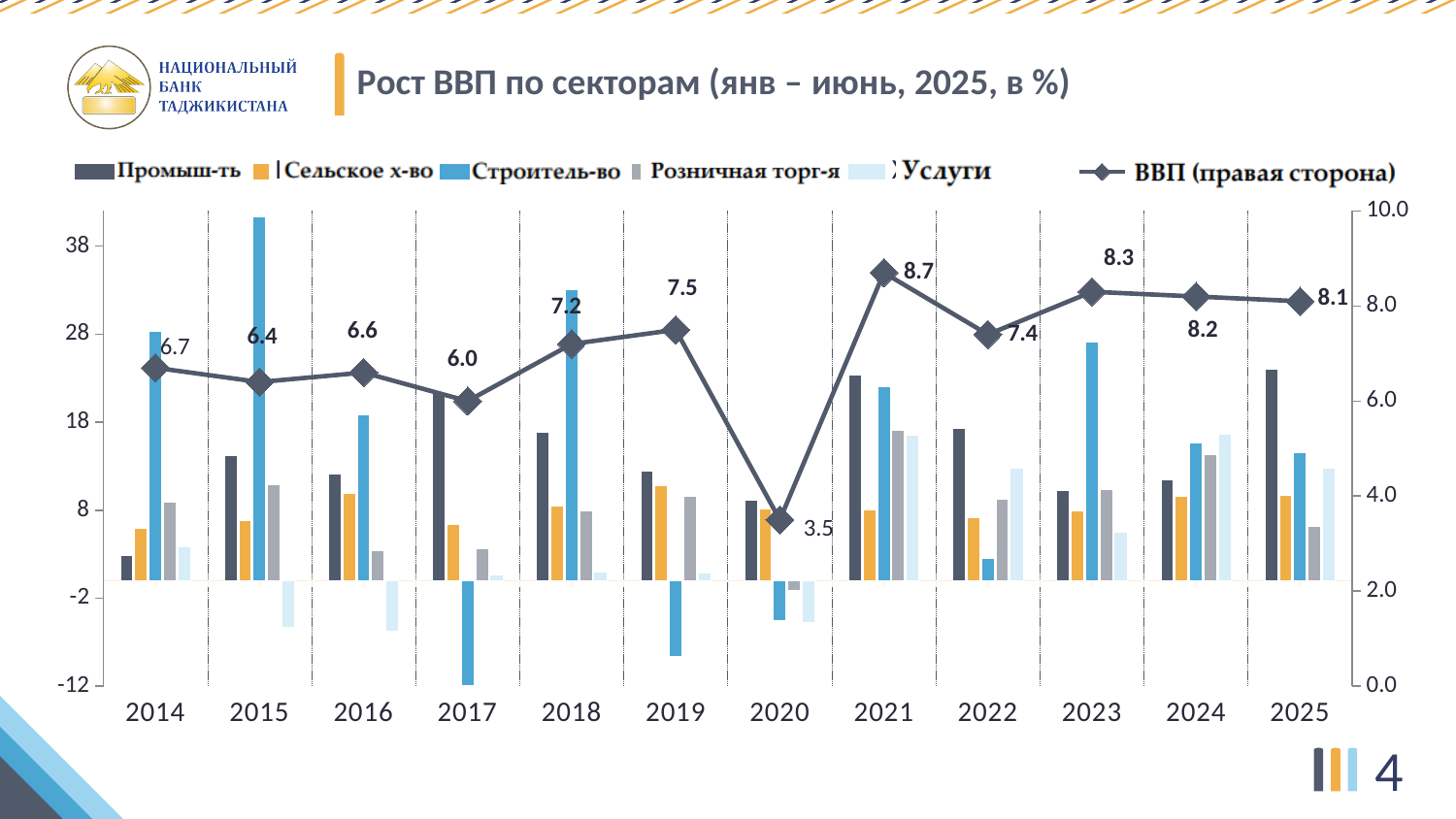
What is the difference between the ВВП values for 2021 and 2020? 5.2 How many series does the legend list? 6 In which year is the ВВП line at its highest? 2021 Is the value for Строитель-во in 2015 greater or less than 28? greater Which year has a higher ВВП value, 2018 or 2017? 2018 What is the ВВП value for 2020? 3.5 In which year is the ВВП line at its lowest? 2020 What is the ВВП value for 2025? 8.1 What is the ВВП value for 2021? 8.7 Does the ВВП line rise or fall from 2017 to 2019? Rise How many years are shown on the x axis? 12 What kind of chart is shown on the slide? Combined bar and line chart